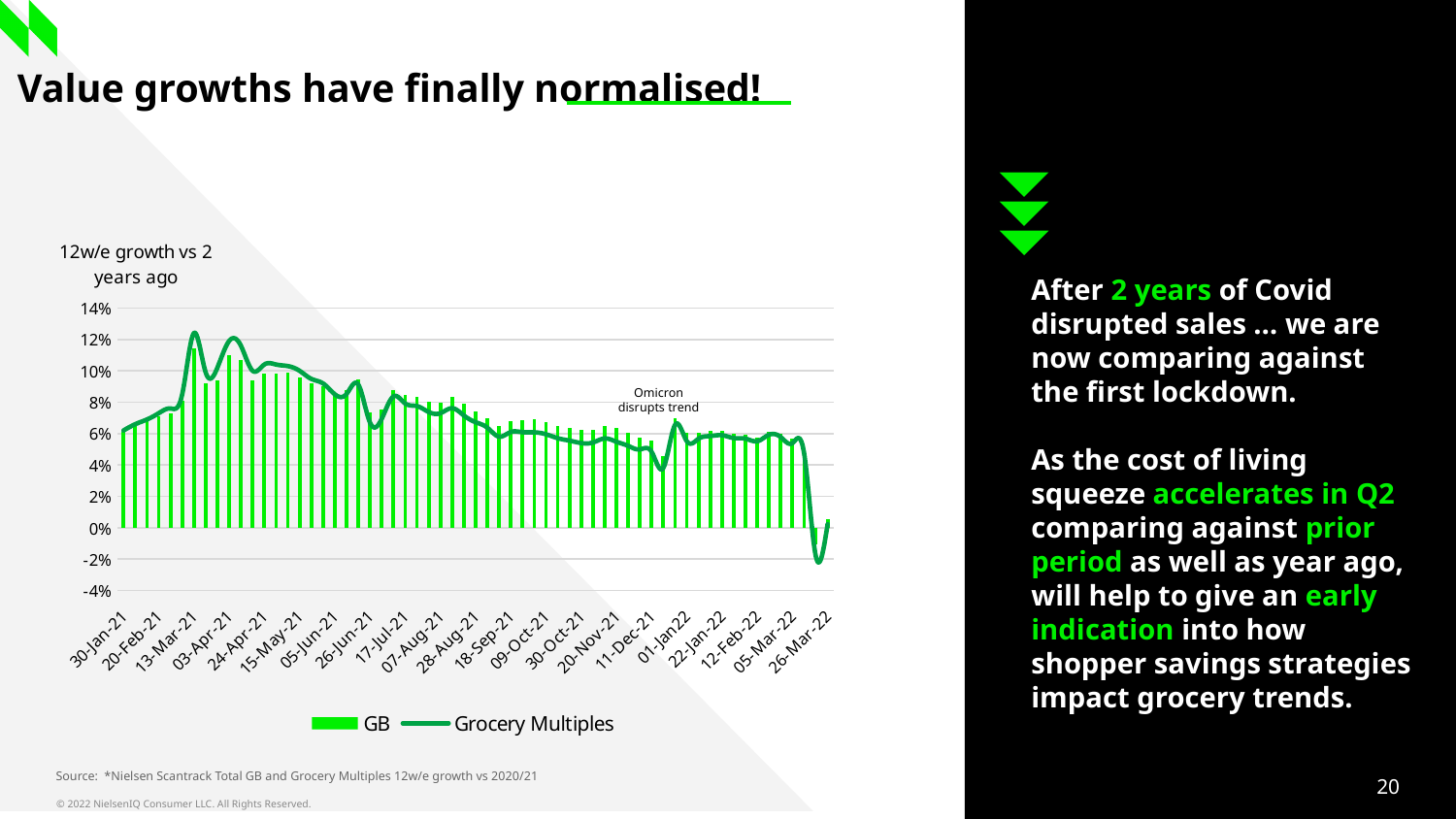
In which month does the Grocery Multiples line reach its lowest value? March 2022 Is the Grocery Multiples value at 26-Mar-22 greater or less than 4%? less Which series is drawn as bars and which as a line? GB is bars; Grocery Multiples is the line Overall, do the growth values rise or fall from 30-Jan-21 to 26-Mar-22? fall Is the Grocery Multiples value at 13-Mar-21 greater or less than 10%? greater Is the GB value at 30-Jan-21 greater or less than 4%? greater What kind of chart is shown on the slide? A combined bar and line chart What event does the annotation on the chart say disrupts the trend? Omicron What is the title of the chart's vertical axis / chart heading? 12w/e growth vs 2 years ago How many series does the chart legend list? 2 Which is larger: the Grocery Multiples value at 13-Mar-21 or at 26-Mar-22? 13-Mar-21